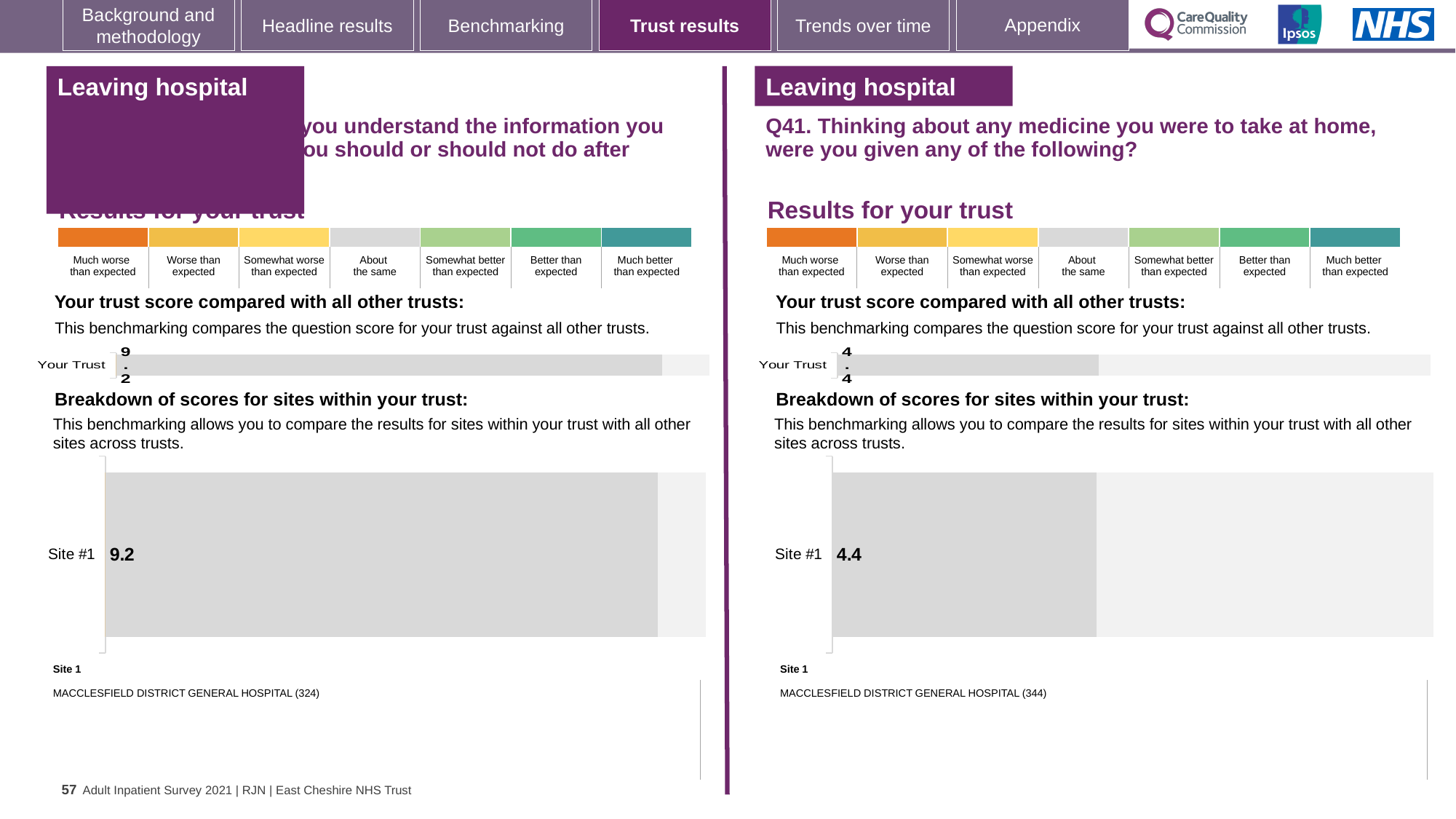
What is the difference between the Site #1 score on the left-hand panel and the Site #1 score on the right-hand panel? 4.8 On the right-hand panel (Q41), what is the score shown for Your Trust? 4.4 What is the question number shown in the title of the right-hand panel? Q41 On the left-hand panel, what is the score shown for Your Trust? 9.2 On the right-hand panel (Q41), what is the score shown for Site #1? 4.4 How many sites are shown in the site breakdown chart on the right-hand panel? 1 Which is larger: the Your Trust score on the left-hand panel or the Your Trust score on the right-hand panel? Left-hand panel How many sites are shown in the site breakdown chart on the left-hand panel? 1 On the left-hand panel, what is the score shown for Site #1? 9.2 On the right-hand panel, is the Site #1 score the same as the Your Trust score? Yes What kind of chart is used to show the Site #1 score on the right-hand panel? Bar chart Which site is listed as Site 1 on the right-hand panel? MACCLESFIELD DISTRICT GENERAL HOSPITAL (344)